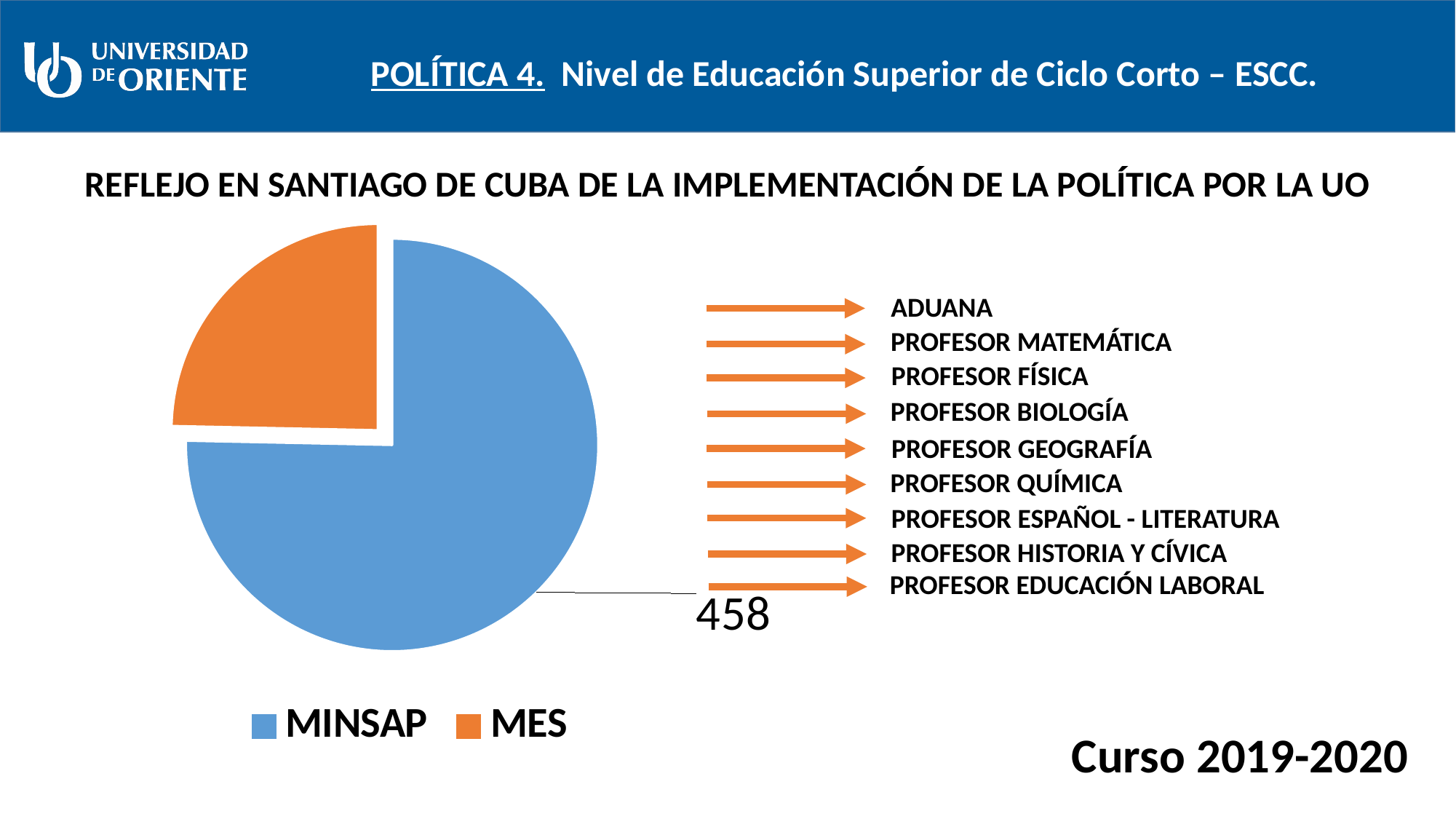
What value is labelled on the MINSAP slice of the pie chart? 458 What kind of chart is shown on the slide? pie chart Which is larger in the pie chart, MINSAP or MES? MINSAP Which slice of the pie chart is the smallest? MES What colour is the MES slice in the pie chart? orange How many slices does the pie chart have? 2 Which slice of the pie chart is the largest? MINSAP What are the two legend entries of the pie chart? MINSAP and MES How many entries does the legend of the pie chart list? 2